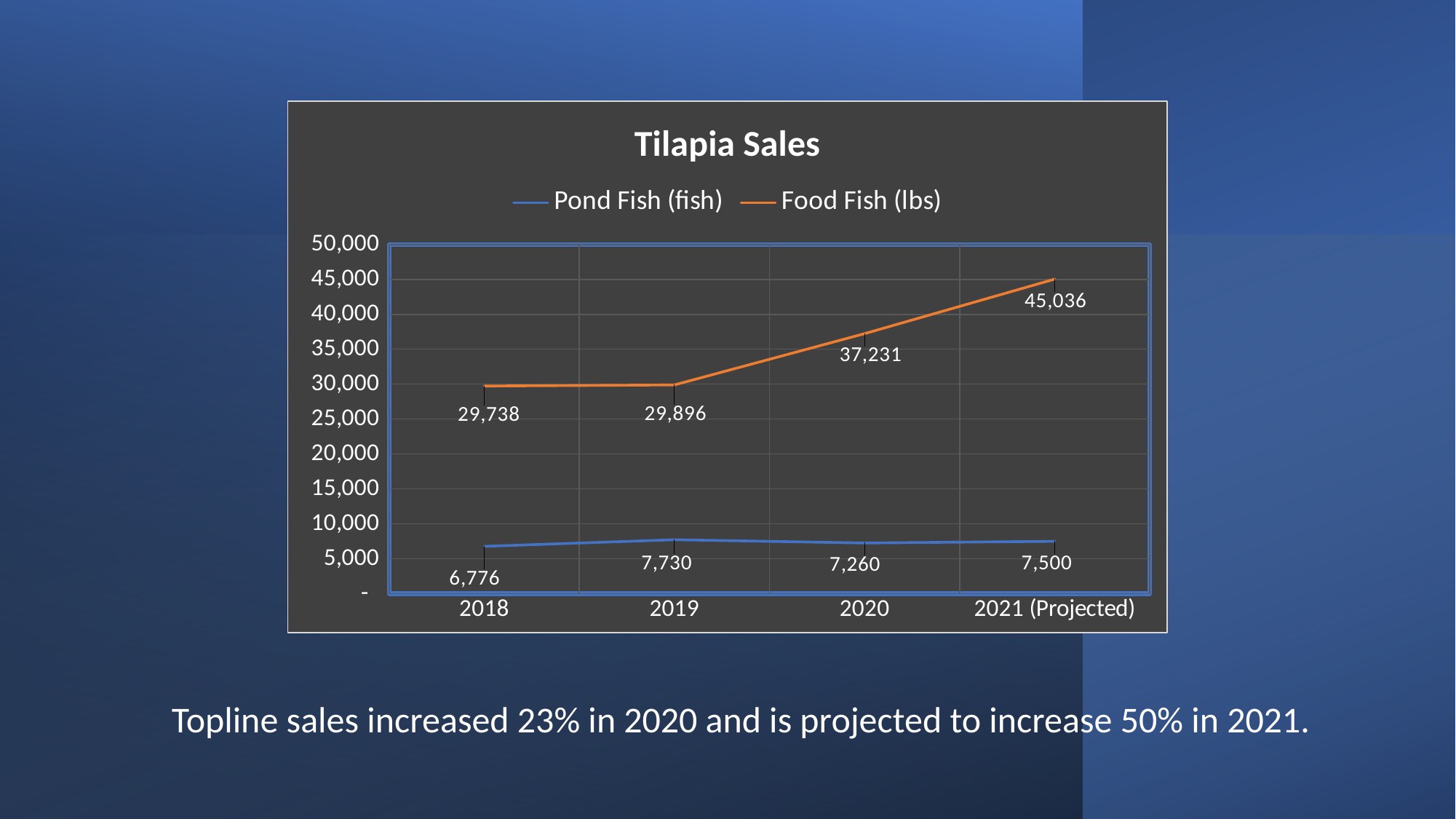
In which year is Food Fish (lbs) lowest? 2018 What is the value for Pond Fish (fish) in 2018? 6,776 Does Food Fish (lbs) rise or fall from 2019 to 2021 (Projected)? rise What is the difference between Food Fish (lbs) in 2021 (Projected) and 2020? 7,805 Is the value for Food Fish (lbs) in 2020 greater or less than 35,000? greater What is the projected value for Food Fish (lbs) in 2021? 45,036 Which is larger: Pond Fish (fish) in 2019 or in 2020? 2019 What is the value for Food Fish (lbs) in 2020? 37,231 What kind of chart is this? line chart How many years are shown on the x axis? 4 How many series does the legend list? 2 In which year is Pond Fish (fish) highest? 2019